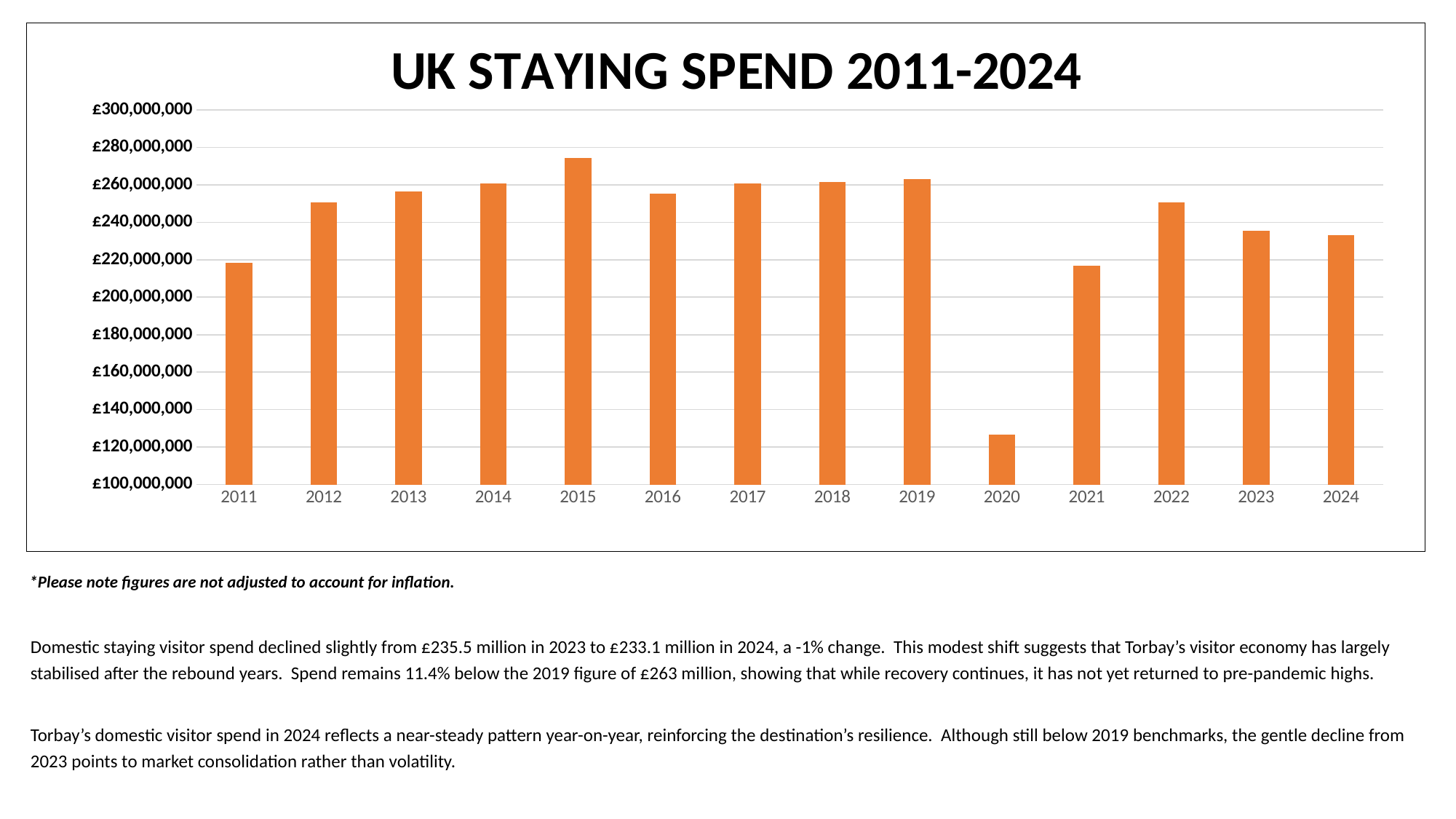
Is the value for 2020 greater or less than £140,000,000? less Which year has the larger UK staying spend, 2011 or 2012? 2012 How many years are plotted on the chart? 14 Is the value for 2022 greater or less than £240,000,000? greater Which year has the highest UK staying spend? 2015 Do the values rise or fall from 2011 to 2015? rise Is the value for 2015 greater or less than £260,000,000? greater Which year has the lowest UK staying spend? 2020 What kind of chart is shown on the slide? bar chart Which year has the larger UK staying spend, 2020 or 2021? 2021 What is the title of the chart? UK STAYING SPEND 2011-2024